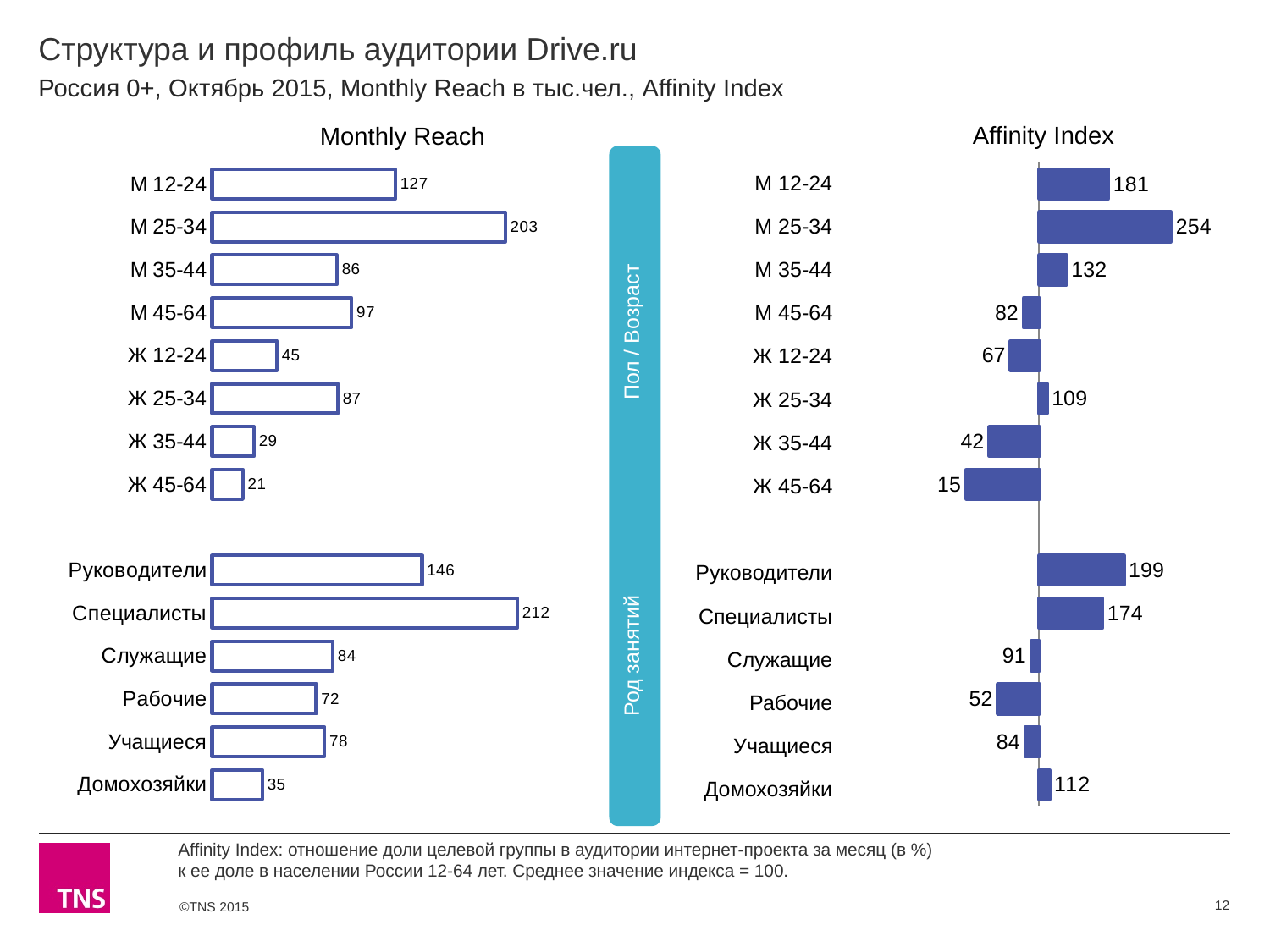
In the Affinity Index chart, what is the difference between М 25-34 and М 12-24? 73 How many categories are plotted in the Monthly Reach chart? 14 In the Monthly Reach chart, what is the value for М 25-34? 203 In the Monthly Reach chart, which category has the highest value? Специалисты In the Affinity Index chart, which category has the lowest value? Ж 45-64 In the Monthly Reach chart, which category has the lowest value? Ж 45-64 In the Affinity Index chart, what is the value for Рабочие? 52 What type of chart is the Affinity Index chart? Bar chart In the Affinity Index chart, which is larger: М 35-44 or Ж 25-34? М 35-44 In the Monthly Reach chart, what is the difference between М 12-24 and Ж 12-24? 82 In the Affinity Index chart, what is the value for Руководители? 199 In the Monthly Reach chart, what is the value for Домохозяйки? 35